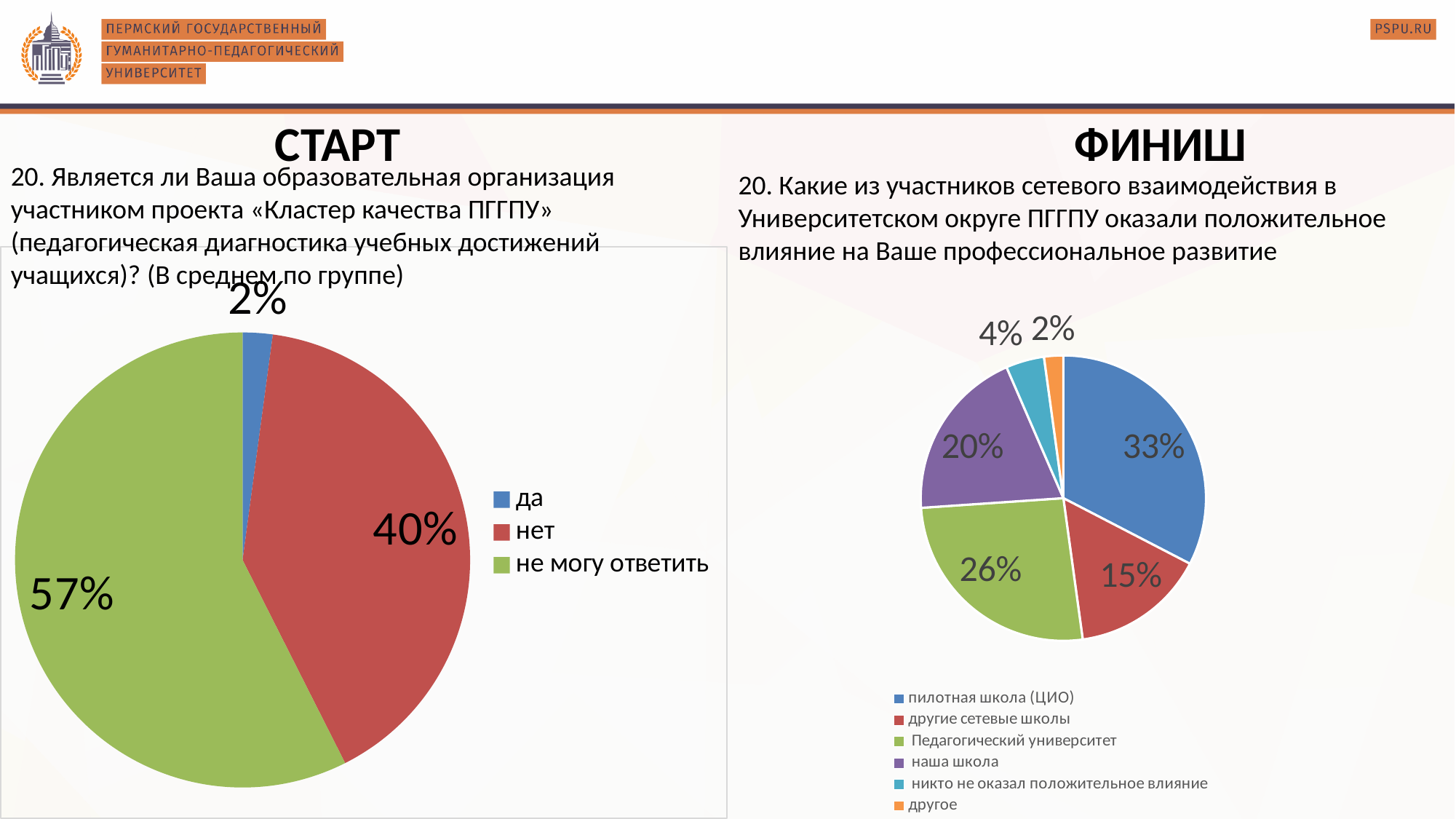
In the left pie chart under СТАРТ, which answer has the smallest share? да In the right pie chart under ФИНИШ, which category has the largest share? пилотная школа (ЦИО) In the right pie chart under ФИНИШ, which is larger: «другие сетевые школы» or «наша школа»? наша школа In the right pie chart under ФИНИШ, what share is attributed to «наша школа»? 20% How many categories does the legend of the left pie chart under СТАРТ list? 3 In the left pie chart under СТАРТ, which answer has the largest share? не могу ответить In the left pie chart under СТАРТ, what is the difference in percentage points between «не могу ответить» and «нет»? 17 In the right pie chart under ФИНИШ, what share is attributed to «Педагогический университет»? 26% How many categories does the legend of the right pie chart under ФИНИШ list? 6 What type of chart is shown under ФИНИШ? pie chart In the left pie chart under СТАРТ, what share of respondents answered «да»? 2% In the left pie chart under СТАРТ, what share of respondents answered «нет»? 40%